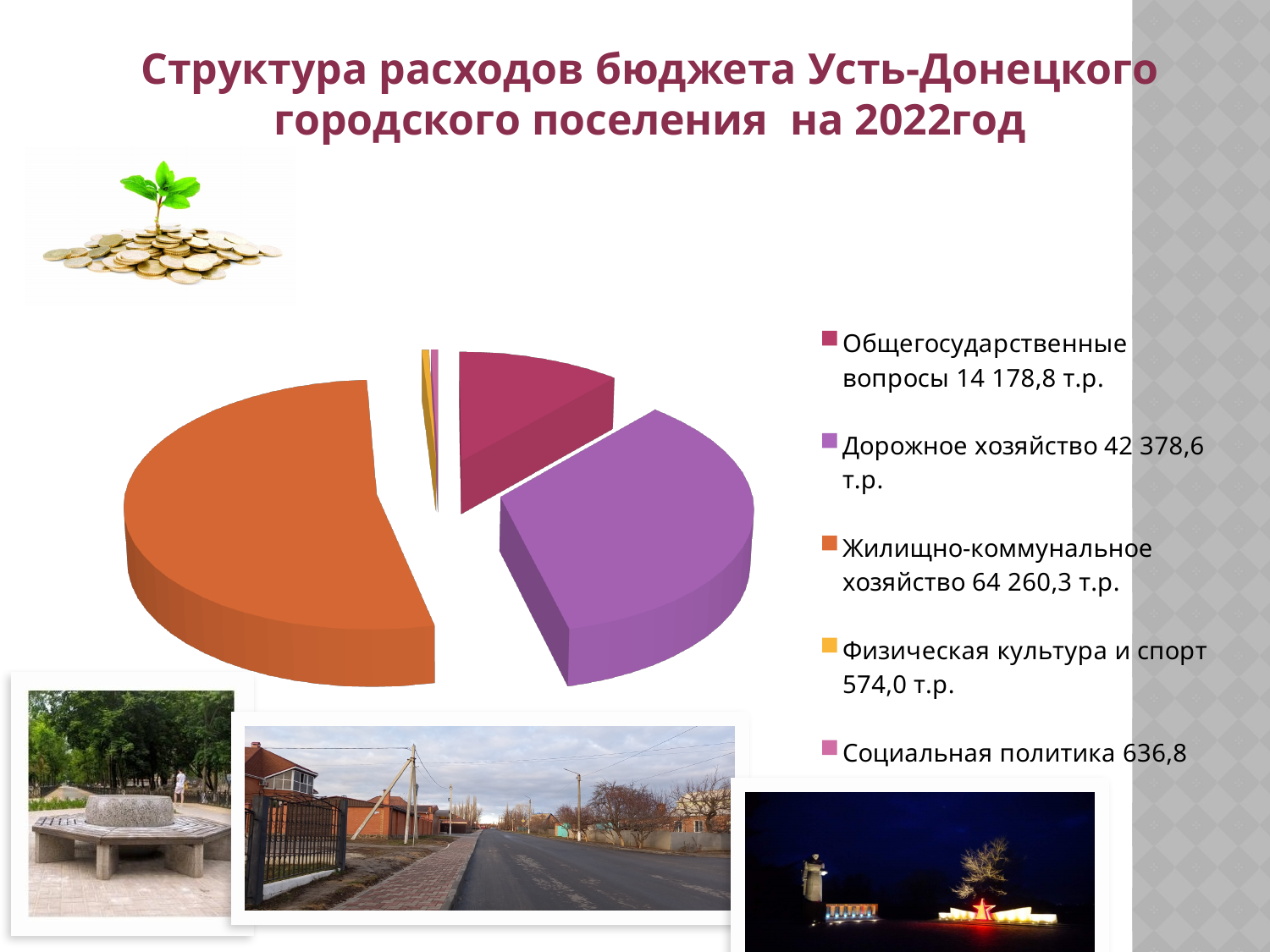
Which is larger, Дорожное хозяйство or Общегосударственные вопросы? Дорожное хозяйство What is the value for Дорожное хозяйство? 42 378,6 т.р. What is the value for Жилищно-коммунальное хозяйство? 64 260,3 т.р. What is the value for Общегосударственные вопросы? 14 178,8 т.р. How many categories does the pie chart show? 5 Which category has the smallest share of the pie? Физическая культура и спорт What kind of chart is shown on the slide? pie chart What is the difference between Жилищно-коммунальное хозяйство and Дорожное хозяйство? 21 881,7 т.р. Which category has the largest share of the pie? Жилищно-коммунальное хозяйство What is the value for Социальная политика? 636,8 What is the value for Физическая культура и спорт? 574,0 т.р. What colour is the slice for Жилищно-коммунальное хозяйство? orange